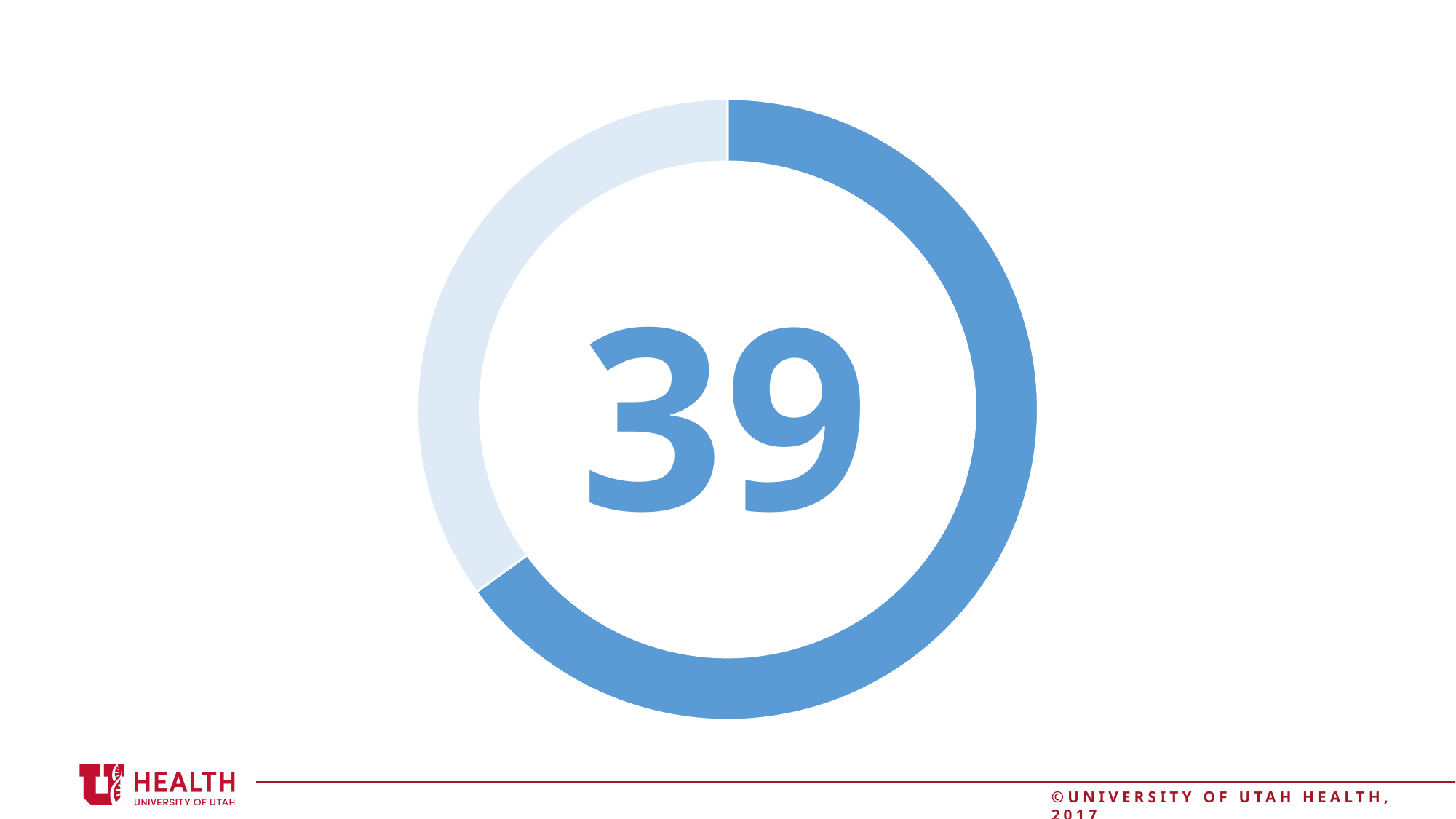
Which segment of the doughnut chart is larger, the dark blue one or the light blue one? The dark blue one How many segments does the doughnut chart have? 2 What kind of chart is shown on the slide? Doughnut chart Does the doughnut chart have a legend? No Does the dark blue segment of the doughnut chart cover more or less than half of the ring? More What colour is the larger segment of the doughnut chart? Dark blue What number is printed in the centre of the doughnut chart? 39